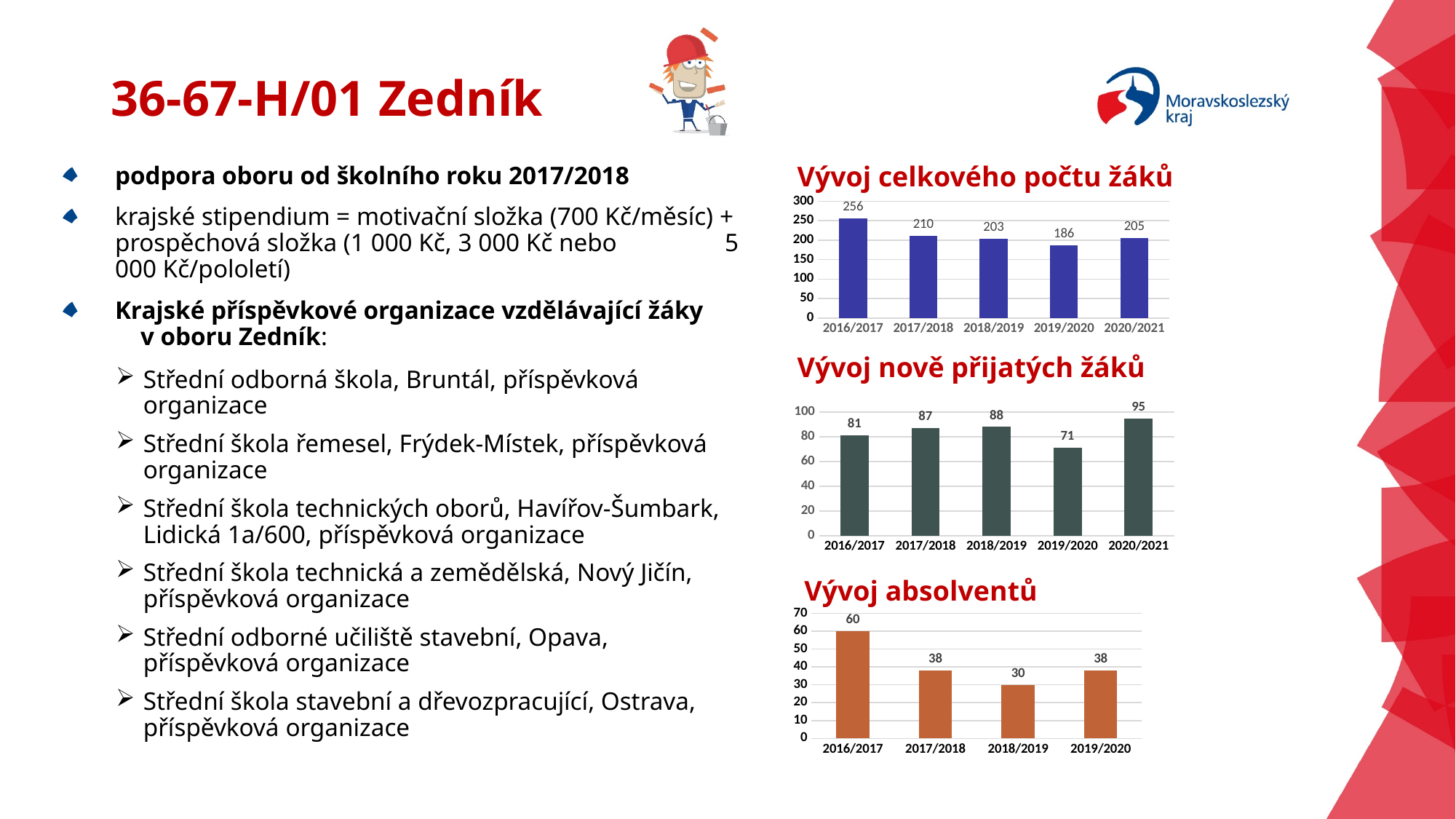
In the chart titled 'Vývoj nově přijatých žáků', which school year has the highest value? 2020/2021 In the chart titled 'Vývoj absolventů', how many school years are shown on the x axis? 4 In the chart titled 'Vývoj nově přijatých žáků', what is the difference between the values for 2020/2021 and 2019/2020? 24 In the chart titled 'Vývoj absolventů', which school year has the highest value? 2016/2017 In the chart titled 'Vývoj celkového počtu žáků', which school year has the lowest value? 2019/2020 In the chart titled 'Vývoj nově přijatých žáků', which is larger, the value for 2017/2018 or the value for 2019/2020? 2017/2018 In the chart titled 'Vývoj absolventů', what is the value for 2018/2019? 30 In the chart titled 'Vývoj celkového počtu žáků', what is the value for 2016/2017? 256 In the chart titled 'Vývoj nově přijatých žáků', what is the value for 2020/2021? 95 In the chart titled 'Vývoj celkového počtu žáků', how many school years are shown on the x axis? 5 What type of chart is the chart titled 'Vývoj absolventů'? Bar chart In the chart titled 'Vývoj celkového počtu žáků', what is the difference between the values for 2016/2017 and 2017/2018? 46